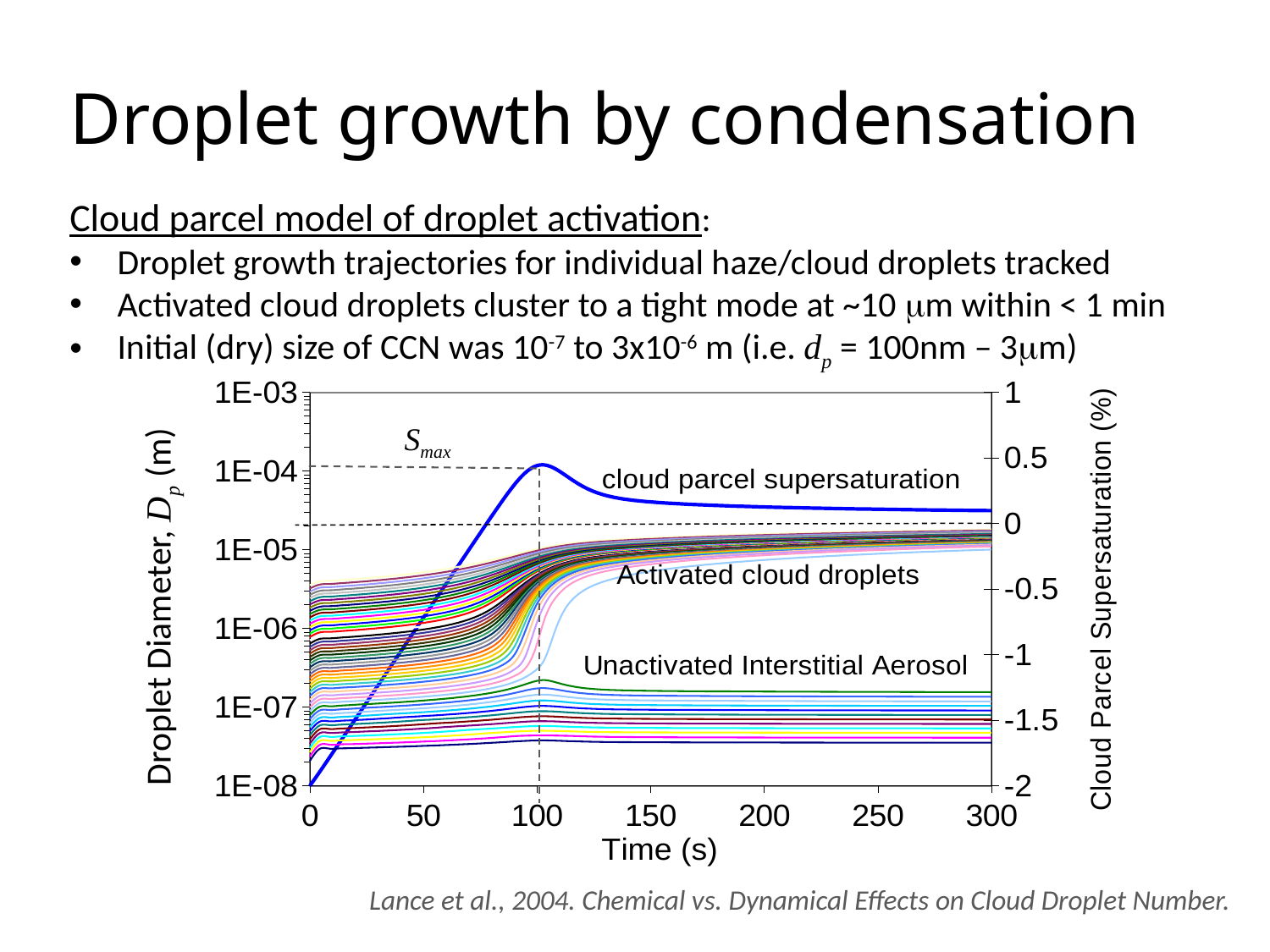
What is the lowest tick value shown on the right y axis (Cloud Parcel Supersaturation)? -2 Does the cloud parcel supersaturation curve rise or fall between time 0 and time 100 s? rise Is the cloud parcel supersaturation at time 300 s greater or less than 0.5? less Is the cloud parcel supersaturation at time 0 s greater or less than -1? less What is the label of the right-hand y axis of the chart? Cloud Parcel Supersaturation (%) What is the highest tick value shown on the left y axis (Droplet Diameter)? 1E-03 What kind of chart is shown on the slide? line chart At what time (s) is the dashed vertical line marking Smax drawn? 100 How many tick labels are shown on the x axis (Time) of the chart? 7 Is the droplet diameter of the Unactivated Interstitial Aerosol curves at time 300 s greater or less than 1E-06? less Does the cloud parcel supersaturation curve rise or fall between time 100 s and time 300 s? fall What is the label of the x axis of the chart? Time (s)